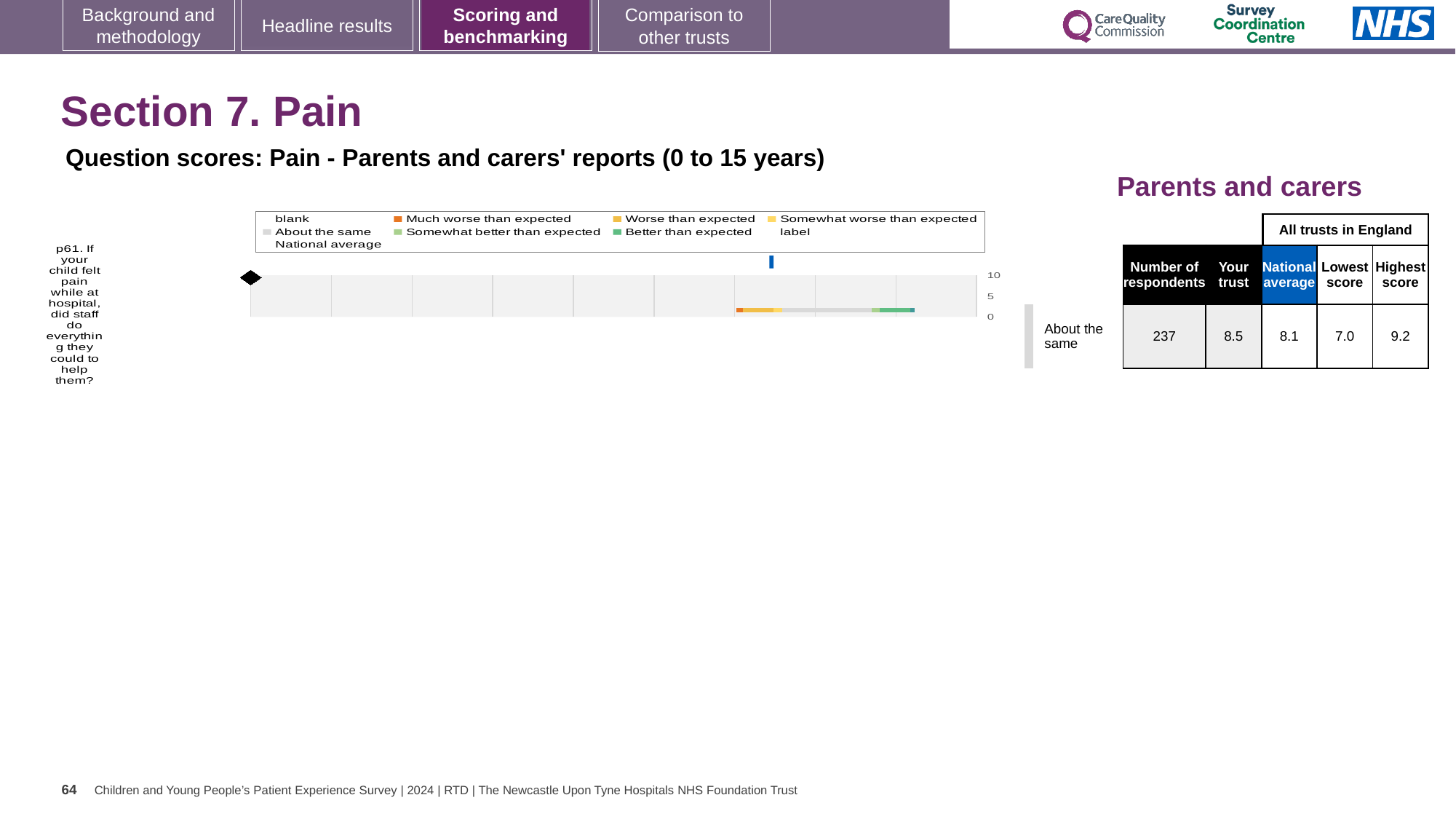
What colour does the legend use for 'Better than expected'? green How many survey questions are plotted in the chart? 1 Which survey question is plotted in the chart? p61. If your child felt pain while at hospital, did staff do everything they could to help them? What is the difference between the highest score and the lowest score for p61? 2.2 In the table, what is the highest score among all trusts in England for p61? 9.2 In the table, what is the lowest score among all trusts in England for p61? 7.0 What benchmark category is the trust's result for p61 placed in? About the same Which is larger for p61: the 'Your trust' score or the national average? Your trust What kind of chart is shown on the slide? bar chart In the table, what is the national average score for p61? 8.1 How many respondents answered p61 according to the table? 237 In the table, what is the 'Your trust' score for p61? 8.5